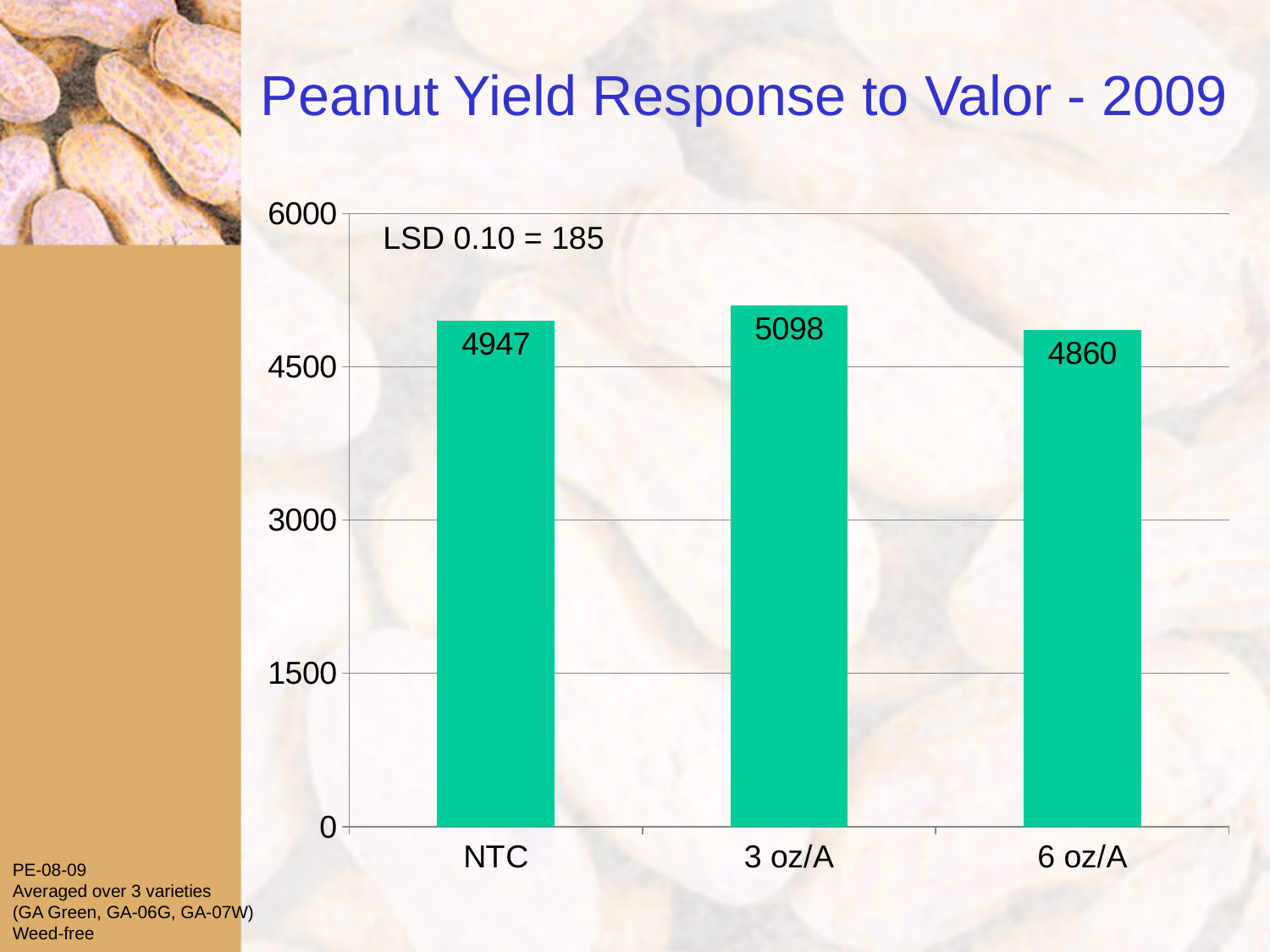
What is the peanut yield for the 3 oz/A treatment? 5098 What is the difference in yield between the NTC and 6 oz/A treatments? 87 Which treatment has the highest peanut yield? 3 oz/A What is the peanut yield for the 6 oz/A treatment? 4860 What is the peanut yield for the NTC treatment? 4947 What is the difference in yield between the 3 oz/A and NTC treatments? 151 What is the LSD 0.10 value shown on the chart? 185 Which treatment has the lowest peanut yield? 6 oz/A Is the yield for the 6 oz/A treatment greater or less than 4500? greater How many treatments are shown on the chart? 3 What type of chart is shown on the slide? Bar chart Which has a higher yield, 3 oz/A or 6 oz/A? 3 oz/A